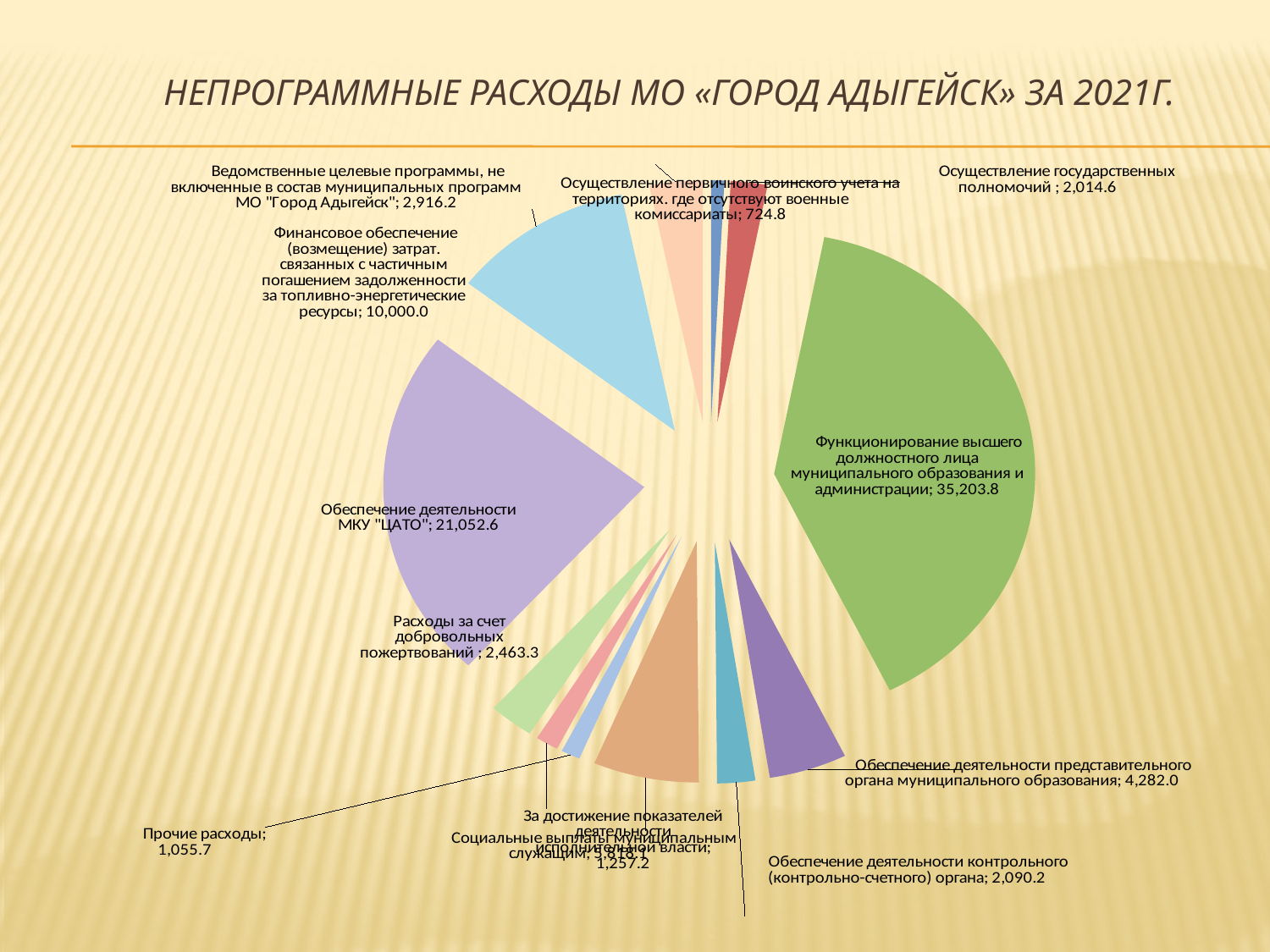
What is the value for "Функционирование высшего должностного лица муниципального образования и администрации"? 35,203.8 What is the value for "Осуществление государственных полномочий"? 2,014.6 Which category has the largest slice of the pie? Функционирование высшего должностного лица муниципального образования и администрации What is the value for "Обеспечение деятельности МКУ "ЦАТО""? 21,052.6 What is the difference between the values for "Функционирование высшего должностного лица муниципального образования и администрации" and "Обеспечение деятельности МКУ "ЦАТО""? 14,151.2 What is the value for "Обеспечение деятельности представительного органа муниципального образования"? 4,282.0 What is the value for "Обеспечение деятельности контрольного (контрольно-счетного) органа"? 2,090.2 What is the value for "Финансовое обеспечение (возмещение) затрат, связанных с частичным погашением задолженности за топливно-энергетические ресурсы"? 10,000.0 What kind of chart is shown on the slide? pie chart What is the value for "Прочие расходы"? 1,055.7 What is the title of the chart? НЕПРОГРАММНЫЕ РАСХОДЫ МО «ГОРОД АДЫГЕЙСК» ЗА 2021Г. Which is larger: "Ведомственные целевые программы, не включенные в состав муниципальных программ МО "Город Адыгейск"" or "Расходы за счет добровольных пожертвований"? Ведомственные целевые программы, не включенные в состав муниципальных программ МО "Город Адыгейск"